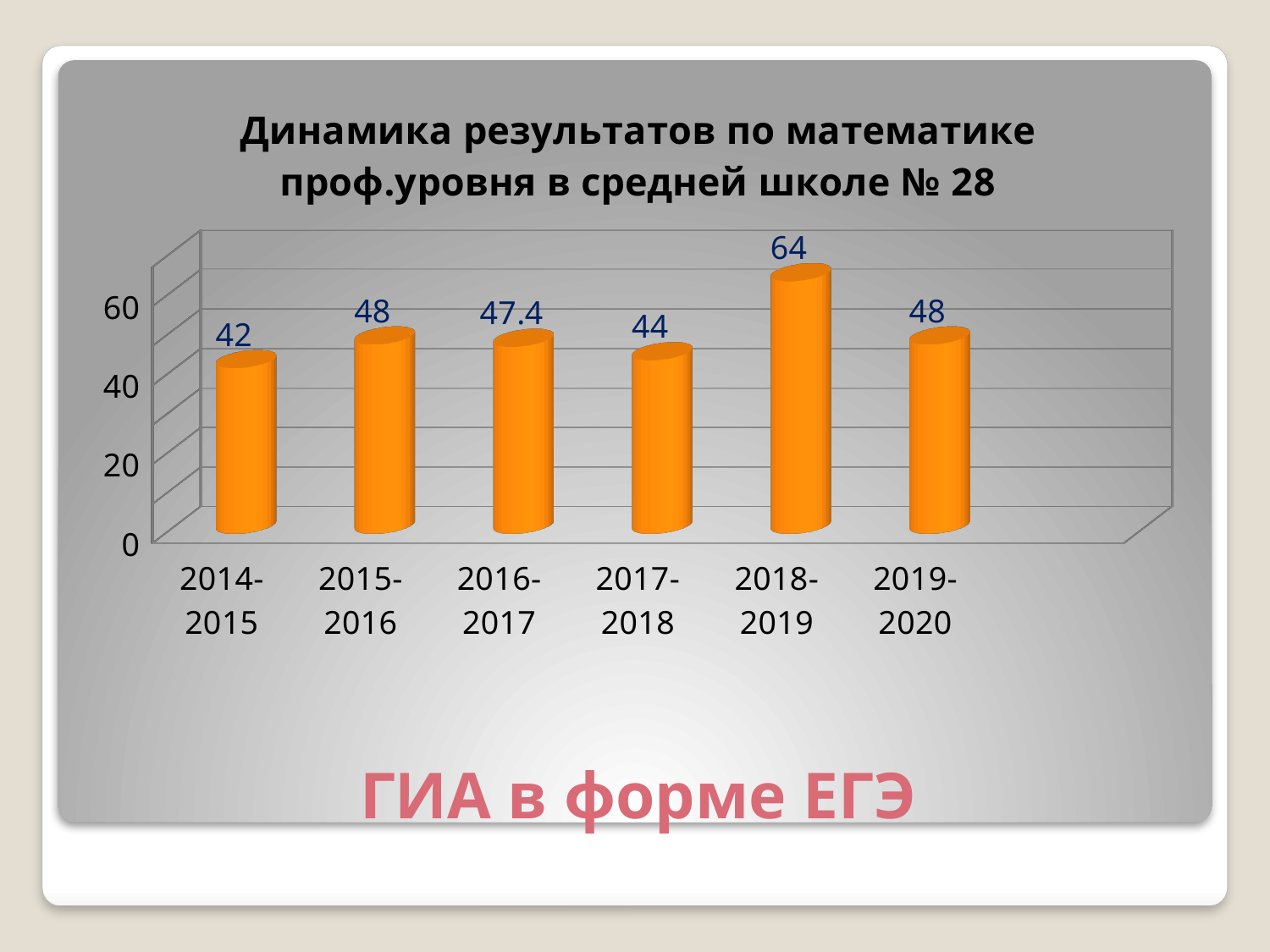
What is the value for 2018-2019? 64 What is the value for 2016-2017? 47.4 What is the title of the chart? Динамика результатов по математике проф.уровня в средней школе № 28 How many categories are shown on the x axis? 6 Which year has the lowest value? 2014-2015 Which year has the highest value? 2018-2019 What is the value for 2014-2015? 42 What is the difference between the values for 2018-2019 and 2017-2018? 20 Did the value rise or fall from 2018-2019 to 2019-2020? fall Is the value for 2018-2019 greater or less than 60? greater What kind of chart is shown on the slide? bar chart Which is larger, the value for 2015-2016 or the value for 2017-2018? 2015-2016